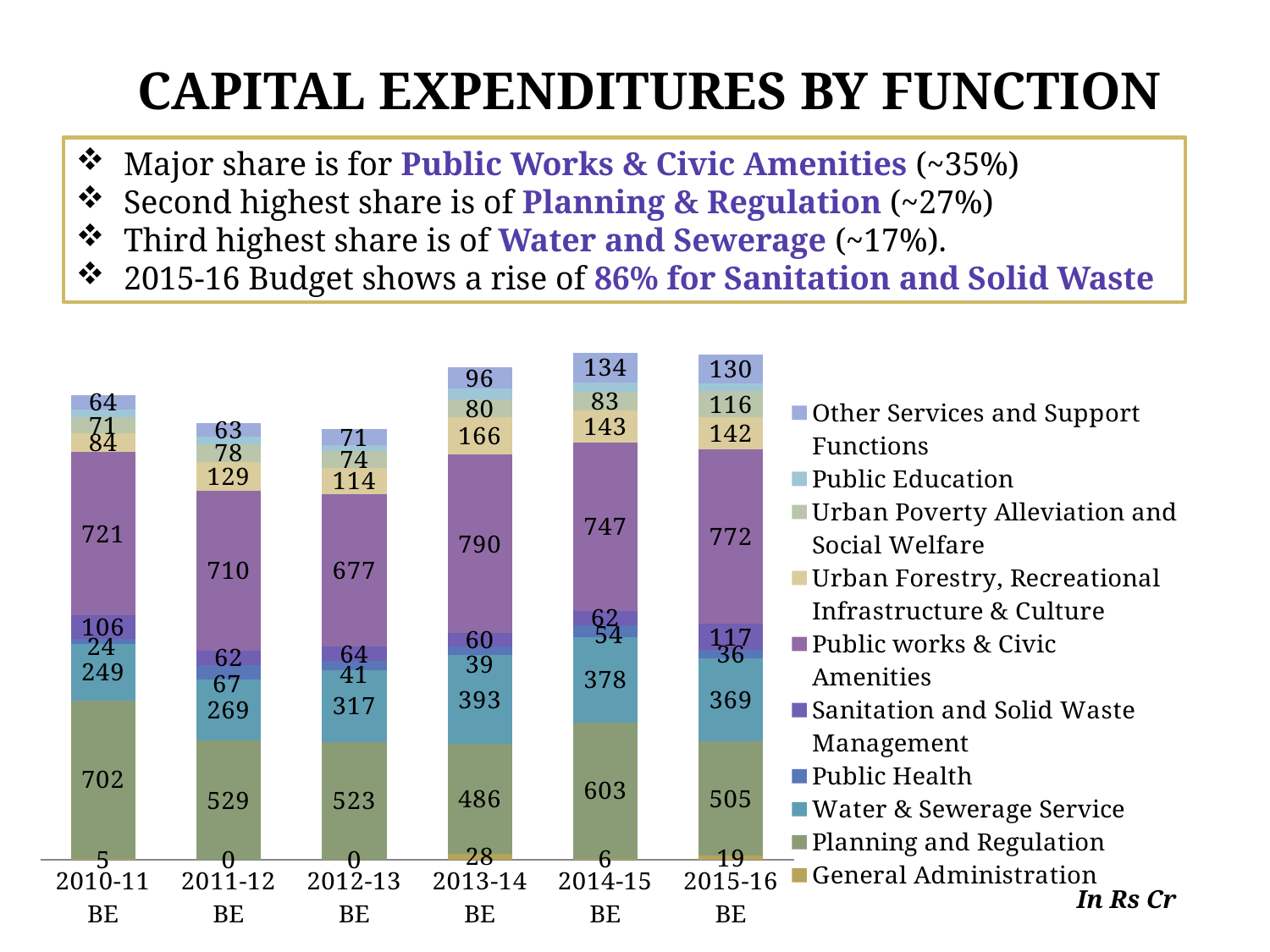
What is the value for Public works & Civic Amenities in 2013-14 BE? 790 What type of chart is shown on the slide? Stacked bar chart How many series does the chart's legend list? 10 Does the Planning and Regulation value rise or fall from 2010-11 BE to 2013-14 BE? Fall Which year has the larger Water & Sewerage Service value, 2013-14 BE or 2014-15 BE? 2013-14 BE What is the value for Water & Sewerage Service in 2015-16 BE? 369 How many budget years (categories) are shown on the x axis of the chart? 6 In which year is the Planning and Regulation value the highest? 2010-11 BE What is the value for General Administration in 2013-14 BE? 28 What is the difference between the Public works & Civic Amenities values for 2015-16 BE and 2014-15 BE? 25 In which year is the Public works & Civic Amenities value the lowest? 2012-13 BE What is the value for Planning and Regulation in 2010-11 BE? 702